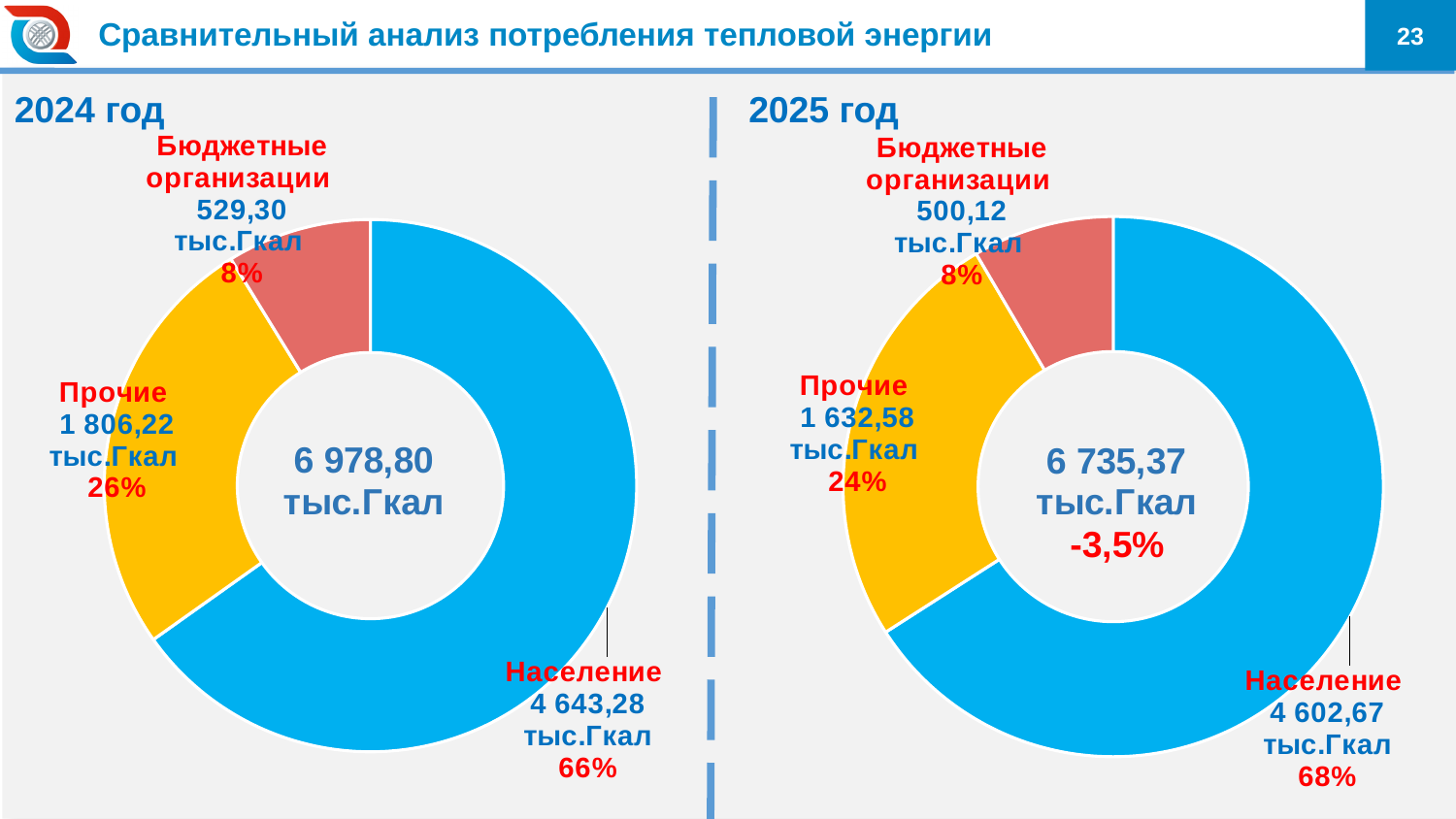
In the 2024 год chart, what is the difference between Население and Прочие? 2 837,06 тыс.Гкал In the 2024 год chart, which category has the largest value? Население What type of chart is used on this slide? Pie (donut) chart In the 2024 год chart, what share of the total does Прочие represent? 26% In the 2025 год chart, which category has the smallest value? Бюджетные организации In the 2024 год chart, what is the value for Население? 4 643,28 тыс.Гкал In the 2025 год chart, what is the value for Бюджетные организации? 500,12 тыс.Гкал In the 2025 год chart, what share of the total does Население represent? 68% In the 2024 год chart, what total is shown in the centre of the donut? 6 978,80 тыс.Гкал In the 2025 год chart, what total is shown in the centre of the donut? 6 735,37 тыс.Гкал In the 2025 год chart, what is the value for Прочие? 1 632,58 тыс.Гкал Which is larger: Население in the 2024 год chart or Население in the 2025 год chart? 2024 год